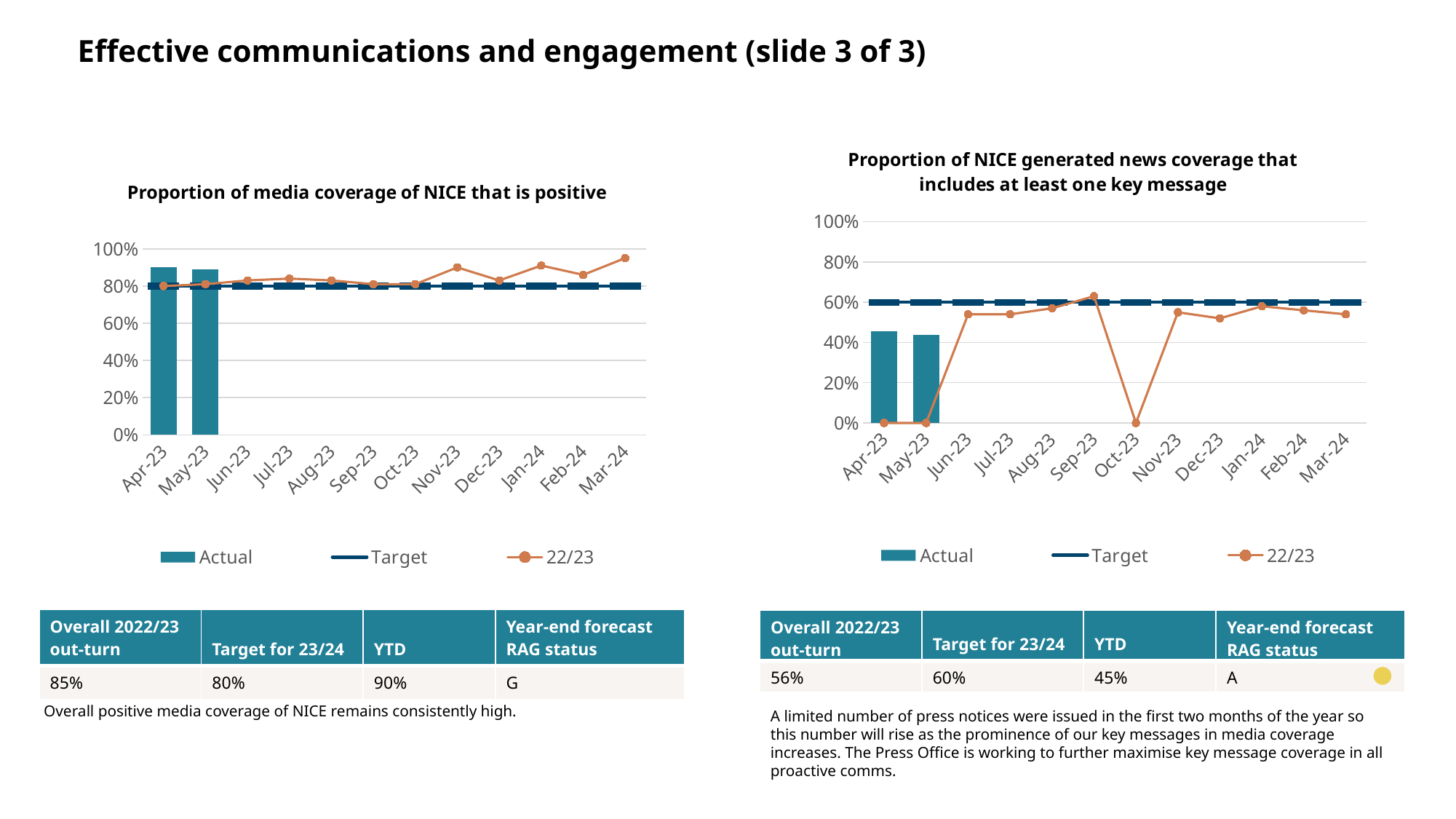
On the 'Proportion of NICE generated news coverage that includes at least one key message' chart, which month has the highest value on the 22/23 line? Sep-23 On the 'Proportion of media coverage of NICE that is positive' chart, is the Actual value for Apr-23 greater or less than 80%? greater What kind of chart is the 'Proportion of NICE generated news coverage that includes at least one key message' chart? Combined bar and line chart On the 'Proportion of media coverage of NICE that is positive' chart, how many months are shown on the x axis? 12 On the 'Proportion of media coverage of NICE that is positive' chart, which is larger on the 22/23 line: Apr-23 or Mar-24? Mar-24 On the 'Proportion of media coverage of NICE that is positive' chart, how many series does the legend list? 3 On the 'Proportion of NICE generated news coverage that includes at least one key message' chart, is the Actual value for Apr-23 greater or less than 60%? less On the 'Proportion of NICE generated news coverage that includes at least one key message' chart, which is larger on the 22/23 line: Sep-23 or Oct-23? Sep-23 On the 'Proportion of NICE generated news coverage that includes at least one key message' chart, what are the three legend entries? Actual, Target, 22/23 On the 'Proportion of NICE generated news coverage that includes at least one key message' chart, is the 22/23 value for Oct-23 greater or less than 20%? less On the 'Proportion of media coverage of NICE that is positive' chart, which month has the highest value on the 22/23 line? Mar-24